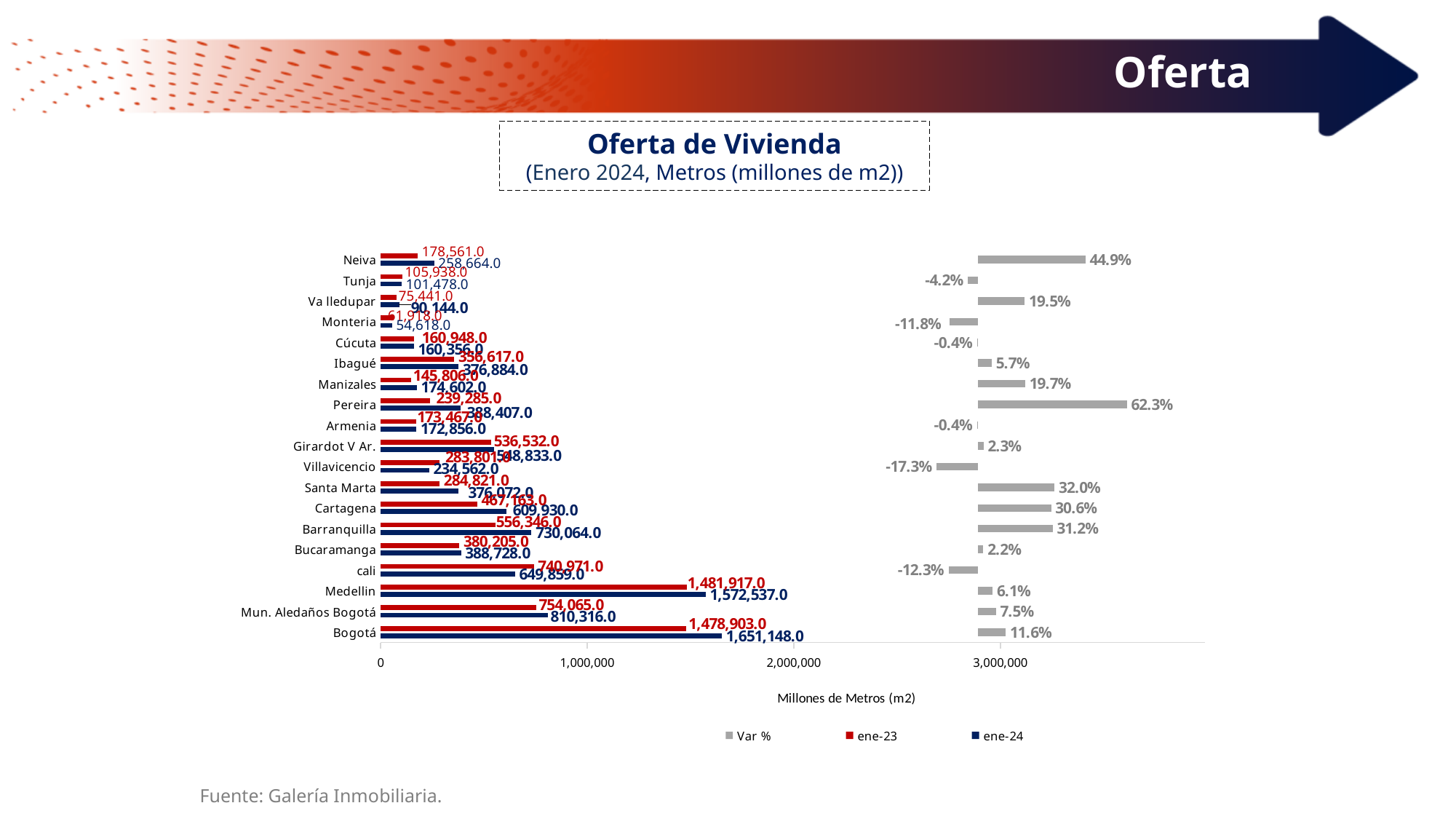
What is the ene-24 value for Medellin? 1,572,537.0 Which city has the highest ene-24 value? Bogotá How many series does the legend list? 3 Which city has the highest Var % value? Pereira What is the ene-24 value for Bogotá? 1,651,148.0 What is the difference between the ene-24 values for Bogotá and Medellin? 78,611.0 What kind of chart is shown on the slide? Bar chart What is the ene-23 value for cali? 740,971.0 What is the Var % value for Pereira? 62.3% How many cities are shown on the chart? 19 For cali, which is larger: the ene-23 value or the ene-24 value? ene-23 Which city has the lowest Var % value? Villavicencio